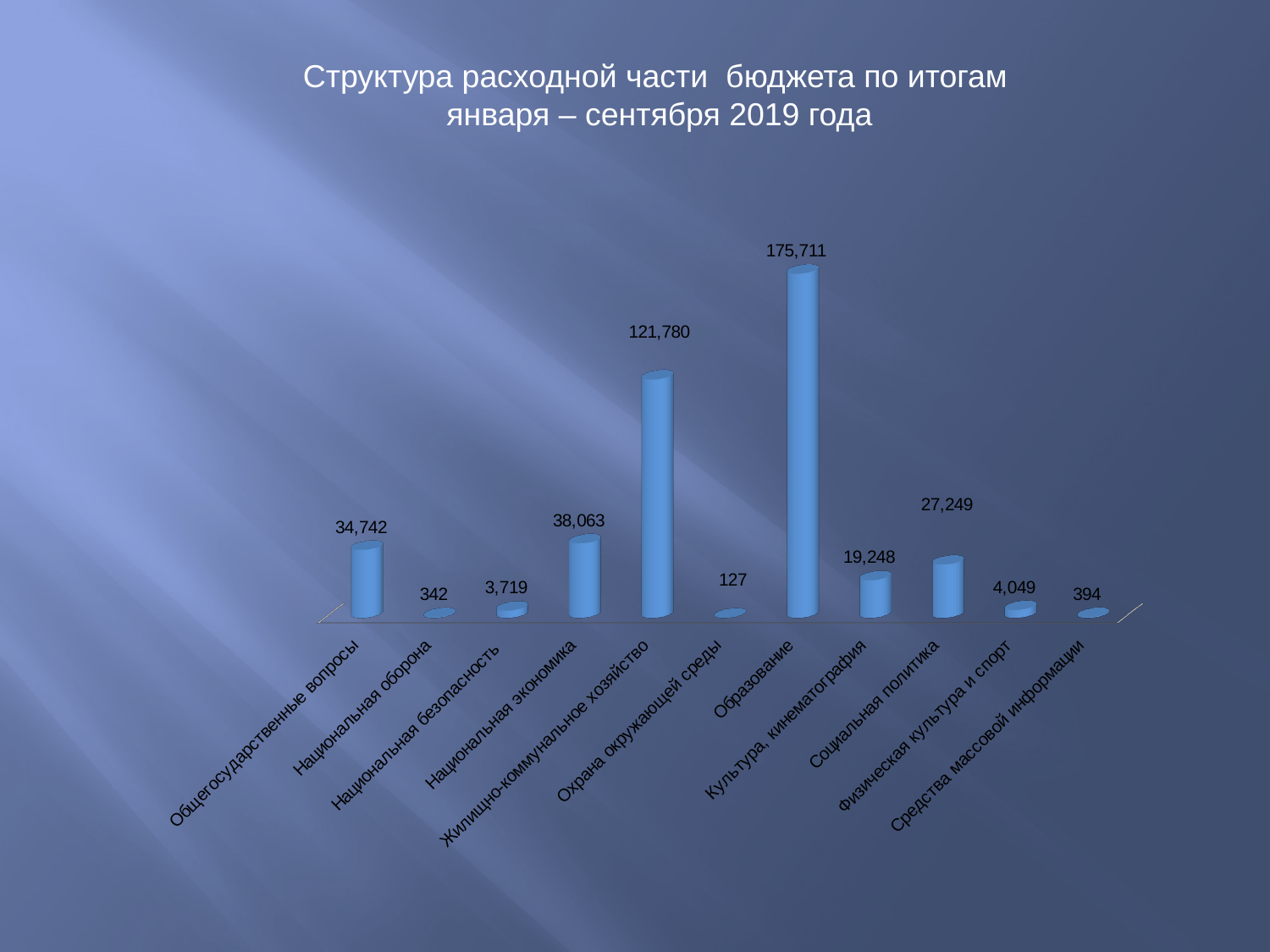
What is the value for Жилищно-коммунальное хозяйство? 121,780 What is the difference between the values for Образование and Жилищно-коммунальное хозяйство? 53,931 What is the value for Социальная политика? 27,249 What is the difference between the values for Социальная политика and Культура, кинематография? 8,001 What is the title of the slide? Структура расходной части бюджета по итогам января – сентября 2019 года What is the value for Образование? 175,711 Which is larger, the value for Национальная экономика or the value for Общегосударственные вопросы? Национальная экономика Which category has the lowest value? Охрана окружающей среды How many categories are shown in the chart? 11 Which category has the highest value? Образование What is the value for Национальная оборона? 342 What kind of chart is shown on the slide? Bar chart